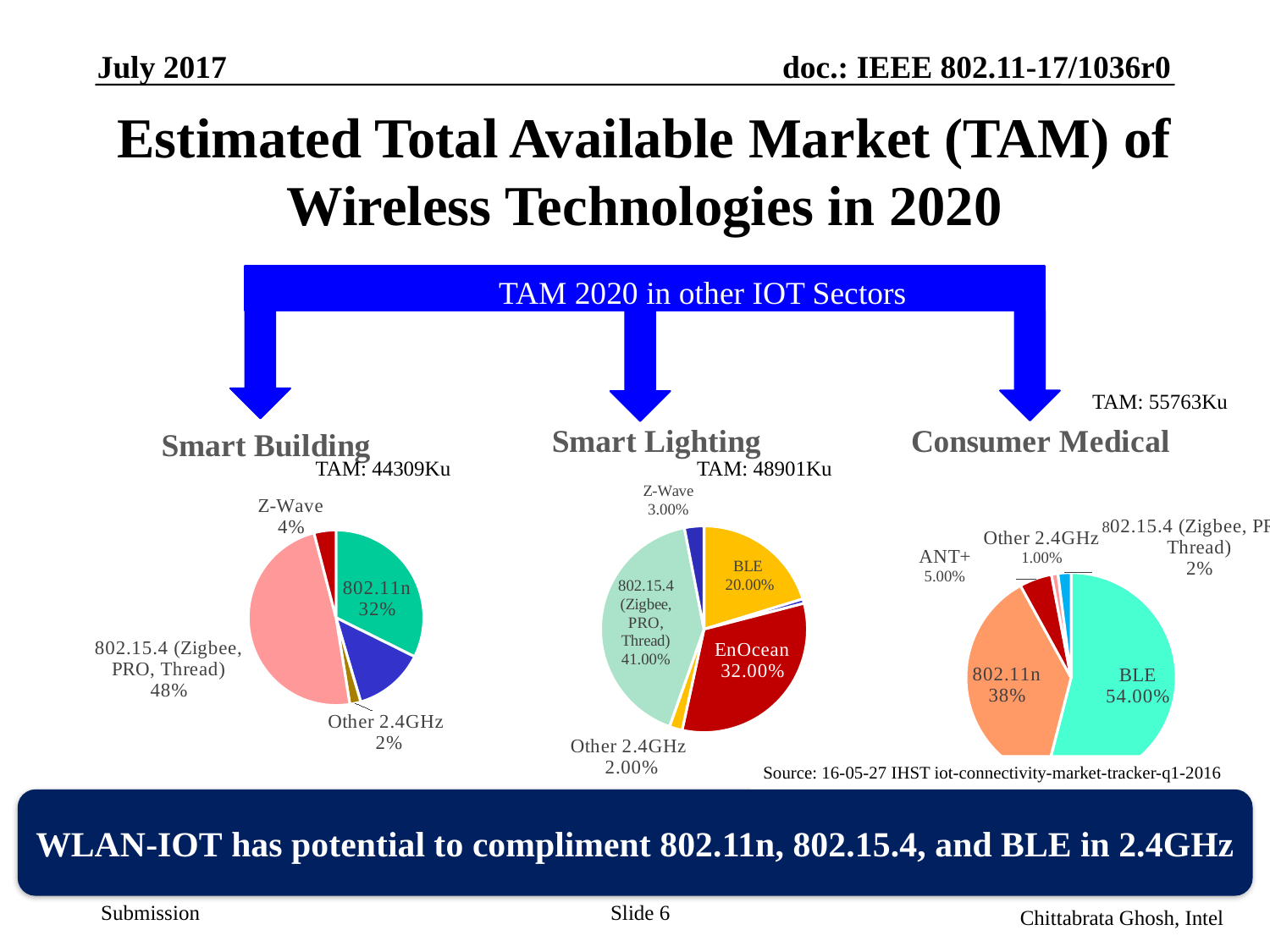
In the Smart Lighting chart, which is larger, BLE or Z-Wave? BLE In the Consumer Medical chart, what is the difference between the BLE share and the 802.11n share? 16% In the Smart Lighting chart, what is the difference between the 802.15.4 (Zigbee, PRO, Thread) share and the BLE share? 21.00% In the Smart Lighting chart, which technology has the largest share? 802.15.4 (Zigbee, PRO, Thread) In the Consumer Medical chart, which technology has the smallest share? Other 2.4GHz What TAM value is shown for the Smart Lighting chart? 48901Ku In the Smart Building chart, which labeled technology has the largest share? 802.15.4 (Zigbee, PRO, Thread) In the Consumer Medical chart, what share does BLE have? 54.00% In the Smart Building chart, what is the difference between the 802.15.4 (Zigbee, PRO, Thread) share and the 802.11n share? 16% What kind of charts are shown on the slide? Pie charts In the Smart Lighting chart, what share does EnOcean have? 32.00% In the Smart Building chart, what share does 802.11n have? 32%